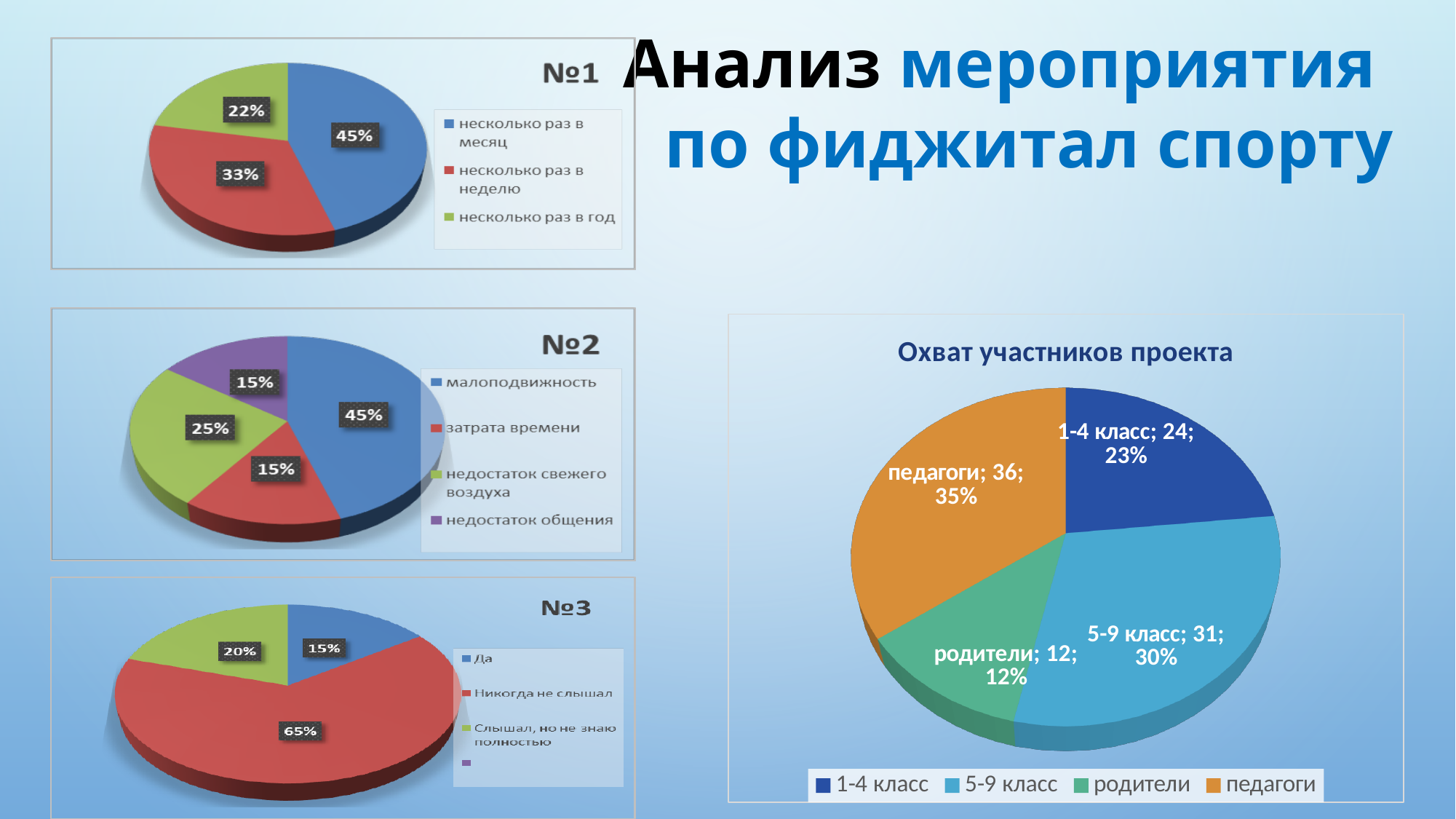
In the chart titled "Охват участников проекта", what share of the pie does "5-9 класс" represent? 30% In the chart titled №1, what is the difference between the shares for "несколько раз в неделю" and "несколько раз в год"? 11% In the chart titled №2, what percentage is shown for "недостаток свежего воздуха"? 25% In the chart titled №1, which category has the smallest share? несколько раз в год How many categories does the legend of the chart titled №2 list? 4 In the chart titled №1, what percentage is shown for "несколько раз в месяц"? 45% In the chart titled "Охват участников проекта", what value is shown for "педагоги"? 36 In the chart titled №3, which is larger: the share for "Да" or the share for "Слышал, но не знаю полностью"? Слышал, но не знаю полностью What type of chart is the chart titled "Охват участников проекта"? Pie chart In the chart titled "Охват участников проекта", what is the difference between the values for "1-4 класс" and "родители"? 12 In the chart titled №3, what percentage is shown for "Никогда не слышал"? 65% In the chart titled №2, which category has the largest share? малоподвижность